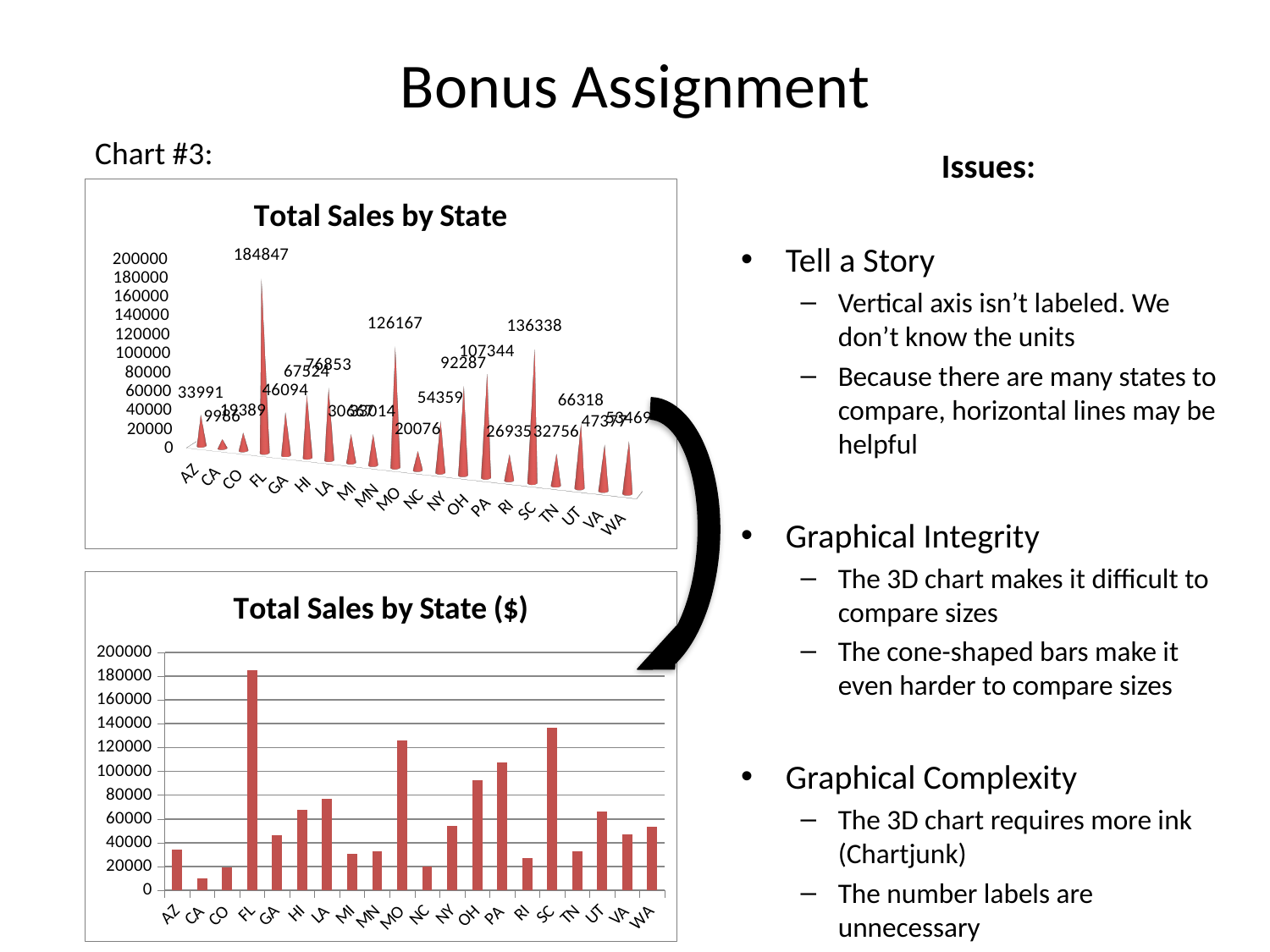
What kind of chart is the bottom chart 'Total Sales by State ($)'? bar chart How many states are shown on the x axis of the bottom chart 'Total Sales by State ($)'? 20 In the bottom chart 'Total Sales by State ($)', is the value for NC greater or less than 40000? less In the top chart 'Total Sales by State', what is the value for CA? 9986 In the top chart 'Total Sales by State', which is larger, the value for PA or the value for OH? PA In the top chart 'Total Sales by State', which state has the highest value? FL In the bottom chart 'Total Sales by State ($)', is the value for FL greater or less than 160000? greater In the top chart 'Total Sales by State', what is the value for MO? 126167 In the top chart 'Total Sales by State', which state has the lowest value? CA In the top chart 'Total Sales by State', what is the difference between the values for SC and MO? 10171 In the top chart 'Total Sales by State', what is the value for SC? 136338 In the top chart 'Total Sales by State', what is the value for FL? 184847